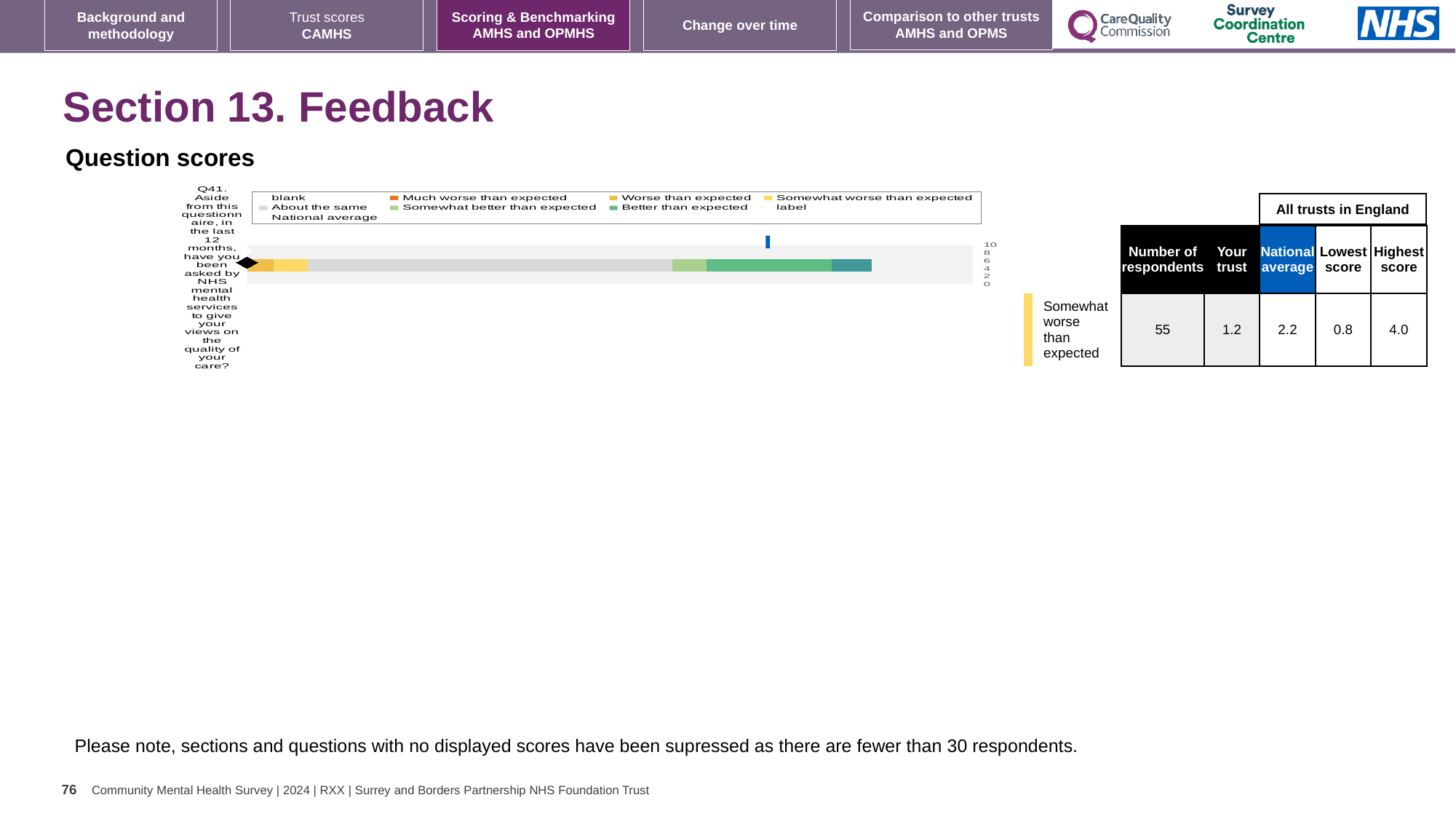
What is the Lowest score among all trusts in England for Q41? 0.8 What is the highest value shown on the chart's axis? 10 What is the 'Your trust' score for Q41 shown next to the chart? 1.2 What is the National average score for Q41 shown next to the chart? 2.2 Which is larger for Q41, the Your trust score or the National average? National average What is the difference between the National average and the Your trust score for Q41? 1.0 What benchmark category is the trust's Q41 score given? Somewhat worse than expected How many questions (categories) are plotted in the bar chart? 1 Which question is plotted in the bar chart? Q41. Aside from this questionnaire, in the last 12 months, have you been asked by NHS mental health services to give your views on the quality of your care? How many respondents answered Q41? 55 What is the Highest score among all trusts in England for Q41? 4.0 What kind of chart is shown on the slide? bar chart